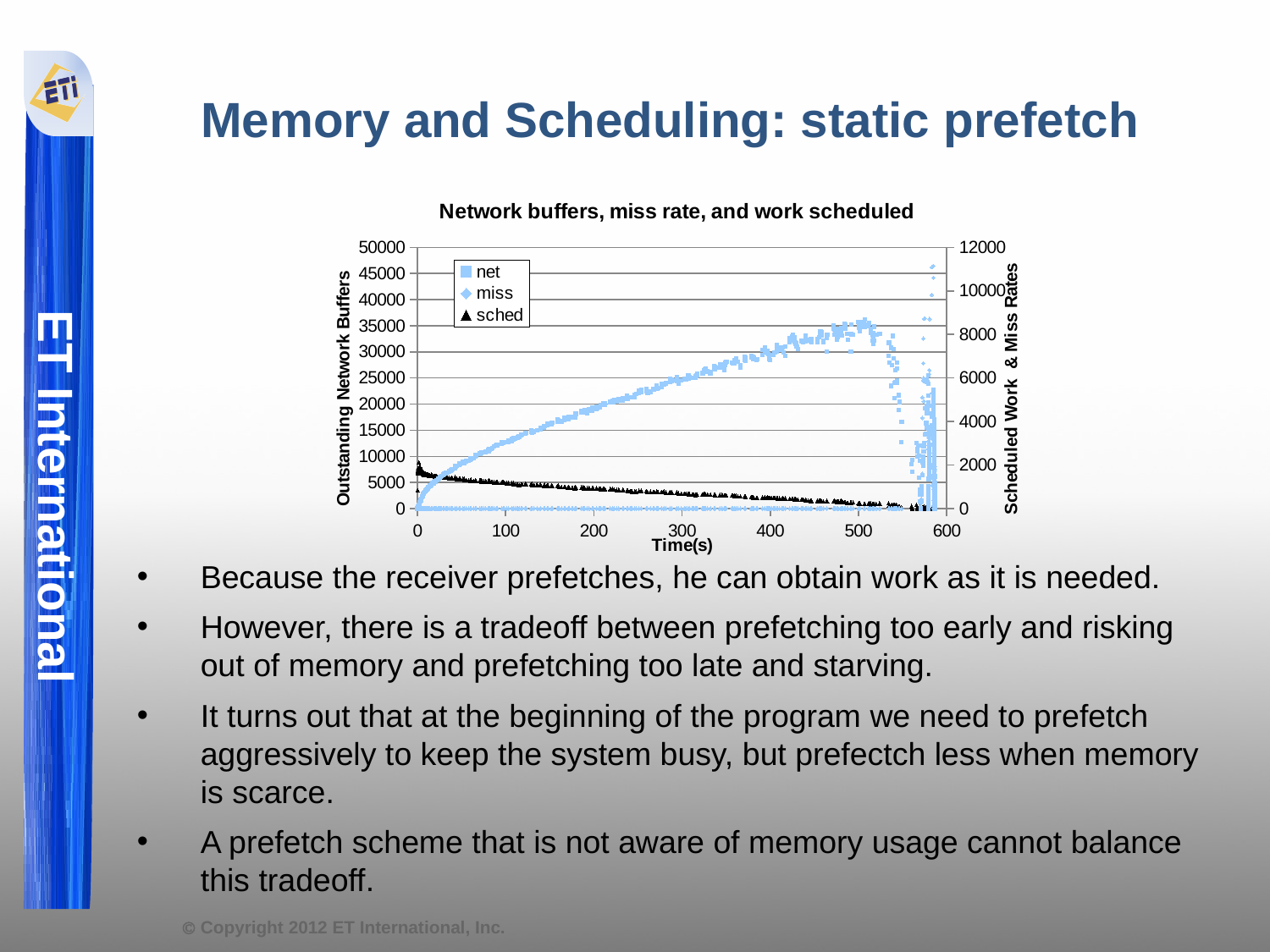
Does the sched series rise or fall as time increases from 0 to 500? fall How many series does the legend of the chart list? 3 Does the net series rise or fall between time 550 and time 600? fall Does the net series rise or fall between time 0 and time 500? rise What are the series names listed in the chart legend? net, miss, sched On the left axis, is the value of the net series at time 300 greater or less than 20000? greater What is the title of the chart? Network buffers, miss rate, and work scheduled On the left axis, is the value of the net series at time 400 greater or less than 25000? greater On the left axis, is the peak value of the net series greater or less than 40000? less What kind of chart is shown on the slide? scatter chart